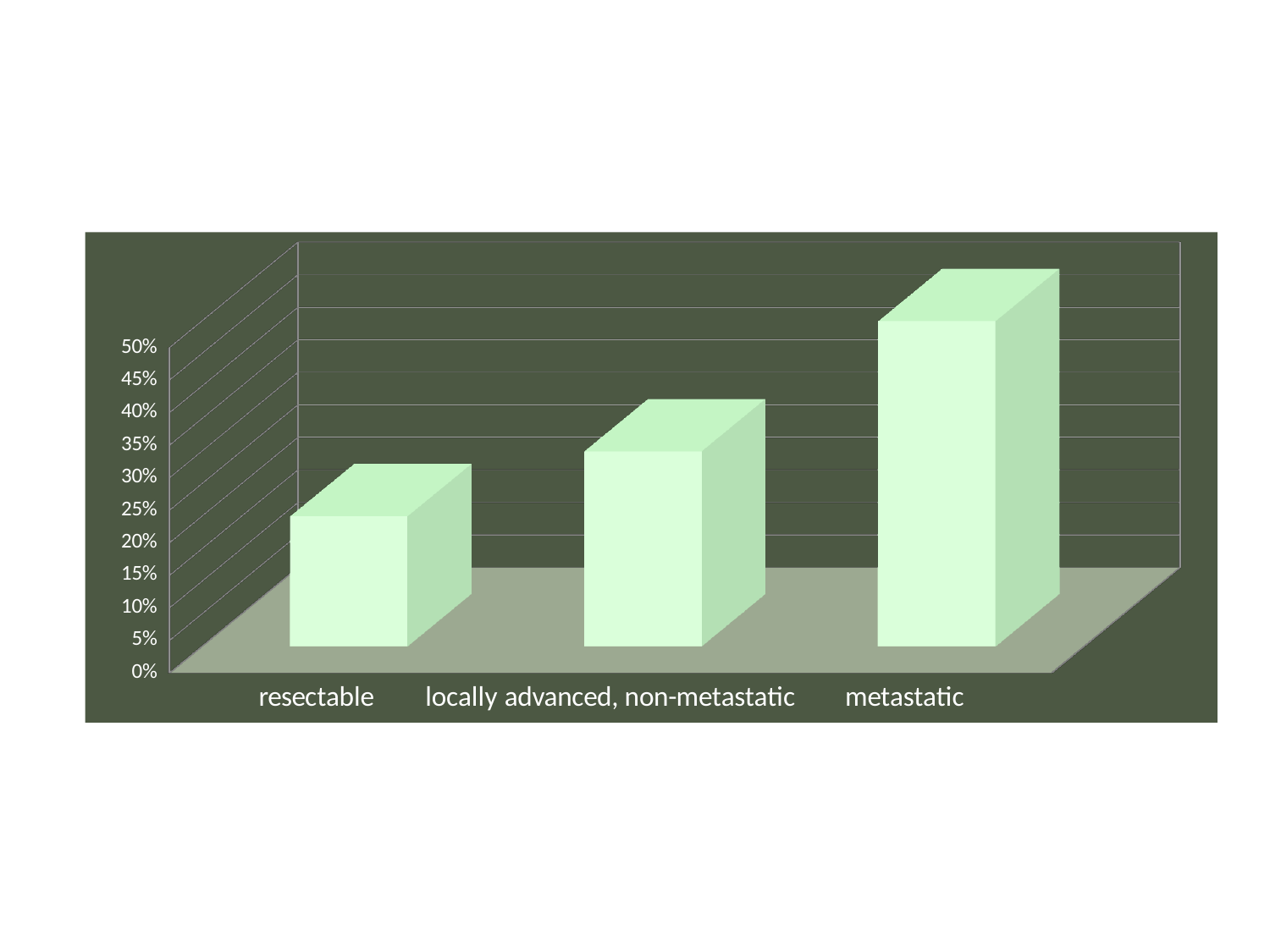
Which category has the lowest value in the chart? resectable What is the label of the middle category on the x axis? locally advanced, non-metastatic What is the highest value shown on the vertical axis of the chart? 50% Which category has the highest value in the chart? metastatic Is the value for metastatic greater or less than 40%? greater What kind of chart is shown on the slide? bar chart Which is larger, the value for locally advanced, non-metastatic or the value for resectable? locally advanced, non-metastatic Is the value for locally advanced, non-metastatic greater or less than 15%? greater How many categories are shown on the x axis of the chart? 3 Do the values rise or fall from left to right along the x axis? rise Which is larger, the value for metastatic or the value for resectable? metastatic Is the value for resectable greater or less than 30%? less